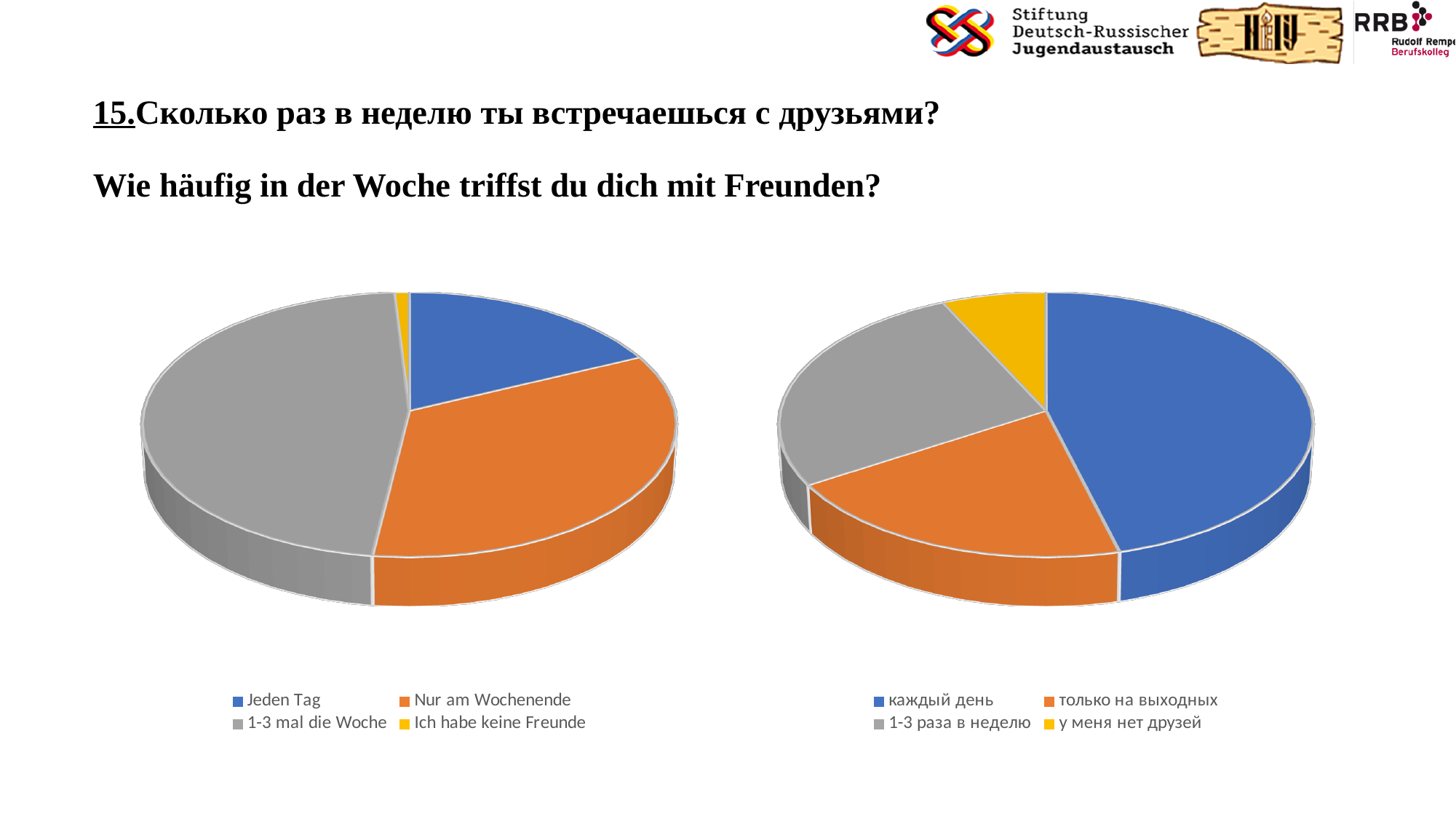
What kind of chart is the right chart on the slide? pie chart In the right pie chart, what colour is the slice for только на выходных? orange In the right pie chart, which category has the smallest slice? у меня нет друзей In the left pie chart, which category has the smallest slice? Ich habe keine Freunde In the right pie chart, which category has the largest slice? каждый день In the right pie chart, which slice is larger: каждый день or 1-3 раза в неделю? каждый день In the left pie chart, what colour is the slice for Ich habe keine Freunde? yellow What kind of chart is the left chart on the slide? pie chart How many slices does the left pie chart have? 4 In the left pie chart, which category has the largest slice? 1-3 mal die Woche In the left pie chart, which slice is larger: Jeden Tag or Nur am Wochenende? Nur am Wochenende How many entries does the legend of the right pie chart list? 4